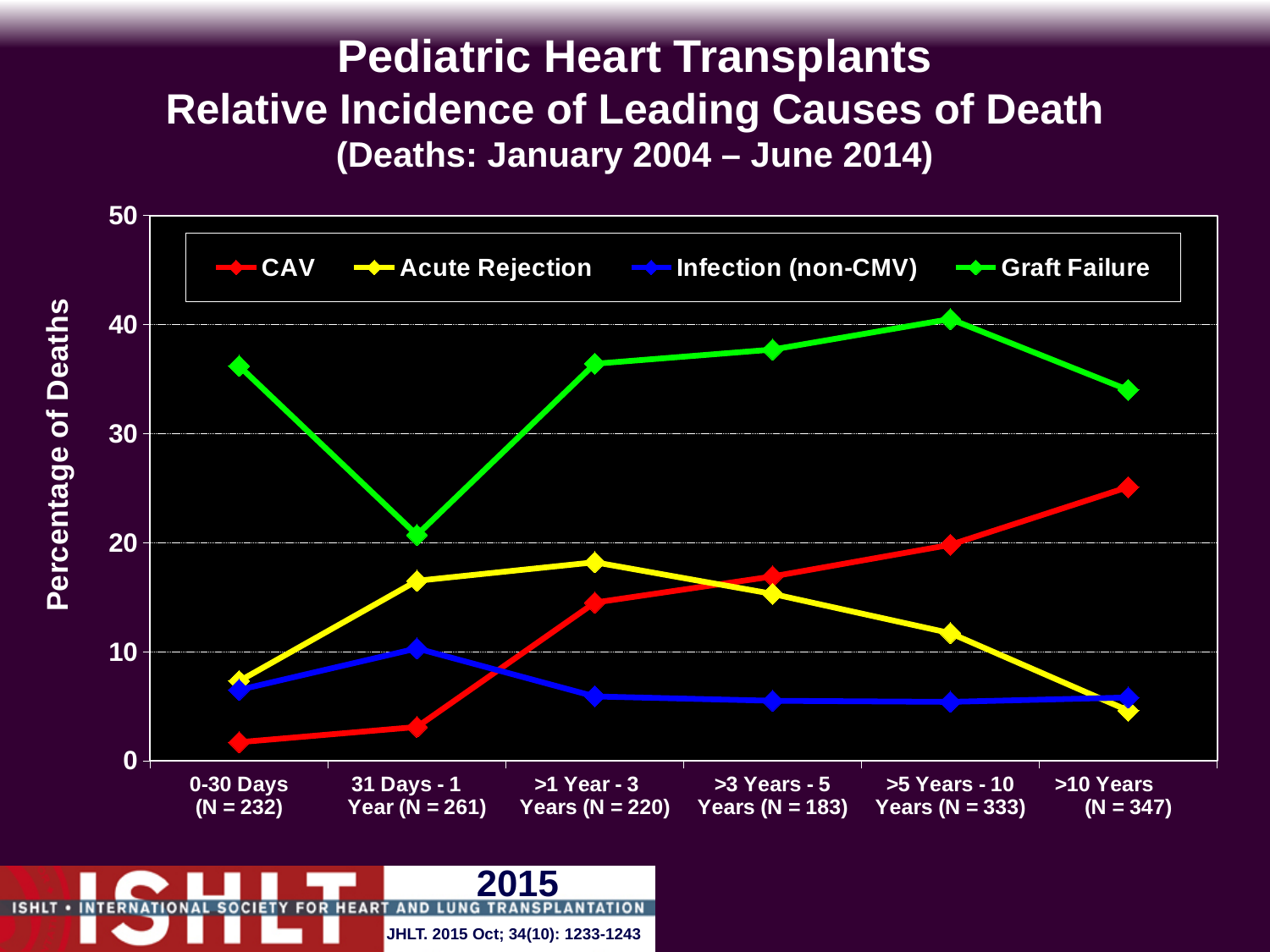
Is the Acute Rejection value for >1 Year - 3 Years greater or less than 20? less Does the CAV line rise or fall as the time since transplant increases along the x axis? rises Is the CAV value for 0-30 Days greater or less than 10? less What colour is the line for Infection (non-CMV)? blue How many time-period categories are shown on the x axis? 6 How many series does the legend list? 4 Which cause of death has the highest percentage of deaths in the >5 Years - 10 Years period? Graft Failure In which time period does Graft Failure reach its lowest percentage of deaths? 31 Days - 1 Year What kind of chart is shown on the slide? line chart Which is larger in the >10 Years period, CAV or Acute Rejection? CAV Which cause of death has the lowest percentage of deaths in the 0-30 Days period? CAV